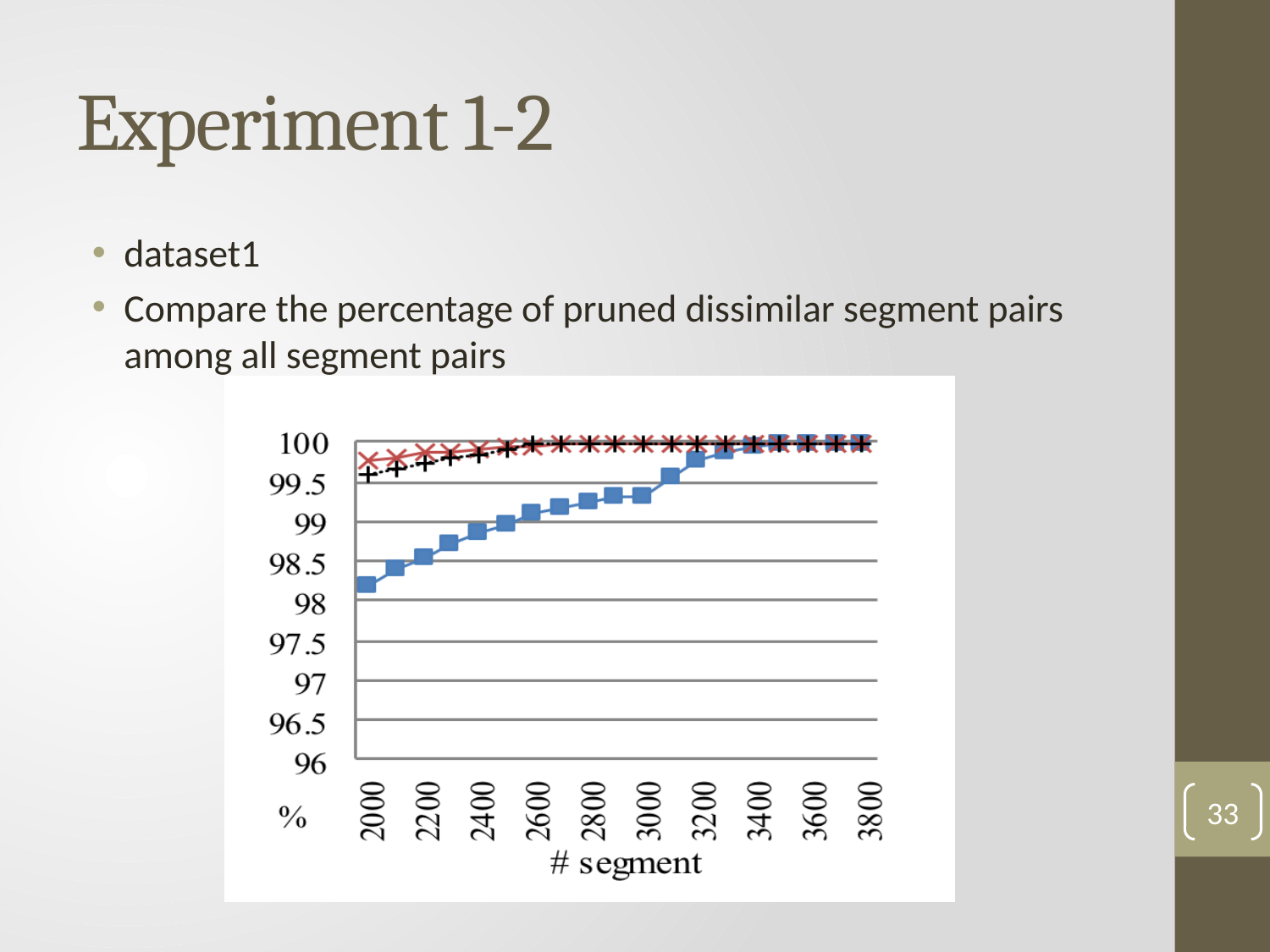
At 2000 segments, which line has the lowest value: the blue square-marker line, the black plus-marker line, or the red x-marker line? the blue square-marker line Is the value of the red x-marker line at 2000 segments greater or less than 99.5? greater What unit is shown on the y axis of the chart? % How many lines (series) are plotted on the chart? 3 Does the blue square-marker line rise or fall as # segment increases from 2000 to 3800? rise At 2000 segments, which is larger: the value of the red x-marker line or the value of the blue square-marker line? the red x-marker line Is the value of the blue square-marker line at 3000 segments greater or less than 99.5? less What kind of chart is shown on the slide? line chart Is the value of the blue square-marker line at 2000 segments greater or less than 98.5? less What is the label of the x axis of the chart? # segment